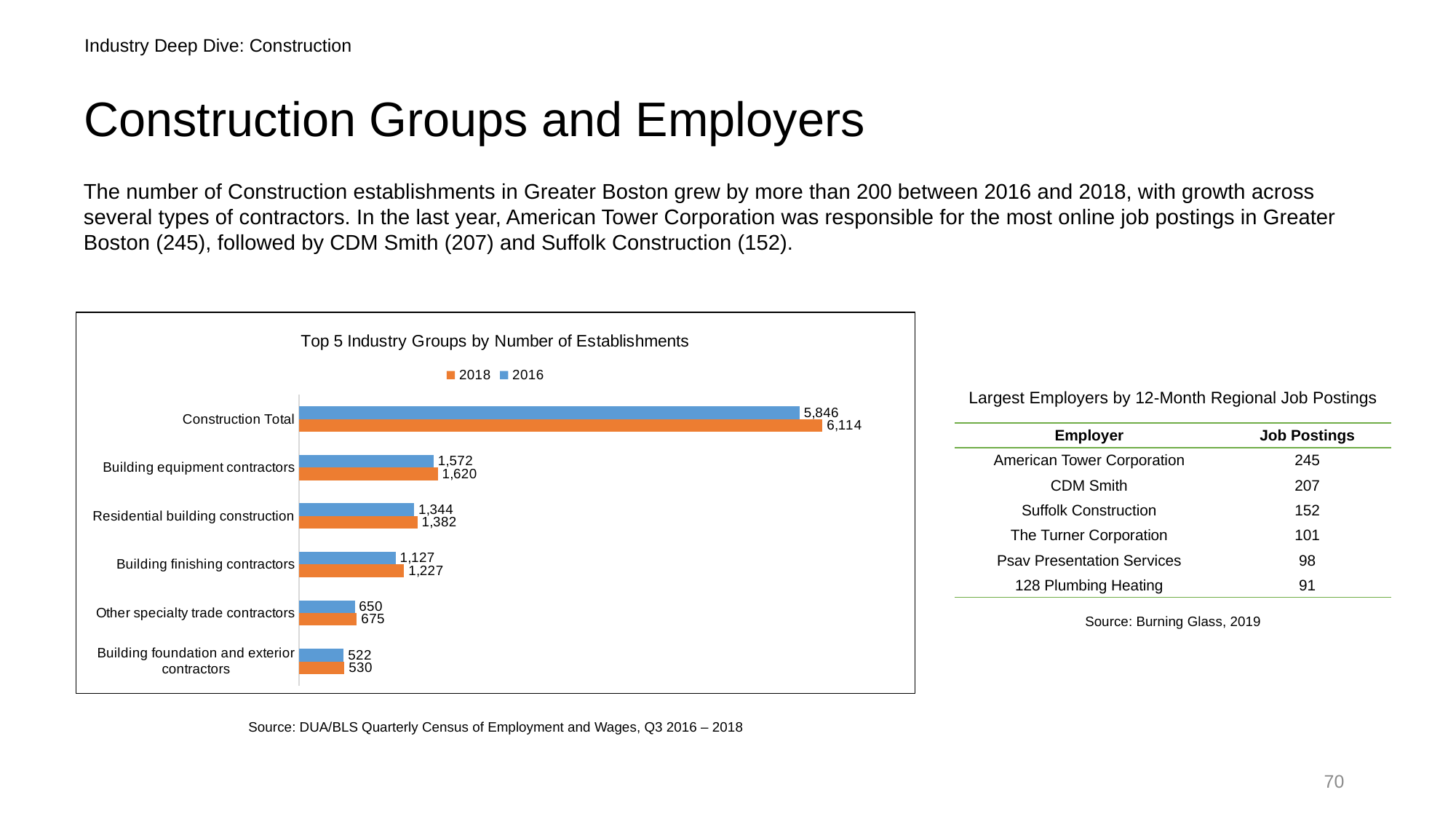
What type of chart is shown on the slide? Bar chart How many series does the chart legend list? 2 What is the 2018 value for Building equipment contractors? 1,620 What is the difference between the 2018 and 2016 values for Building finishing contractors? 100 Which is larger: the 2018 value for Residential building construction or the 2018 value for Building finishing contractors? Residential building construction What is the 2016 value for Residential building construction? 1,344 Excluding Construction Total, which category has the highest 2016 value? Building equipment contractors How many categories are shown on the chart? 6 What is the 2016 value for Other specialty trade contractors? 650 What is the difference between the 2018 and 2016 values for Construction Total? 268 What is the 2018 value for Construction Total? 6,114 Excluding Construction Total, which category has the lowest 2018 value? Building foundation and exterior contractors